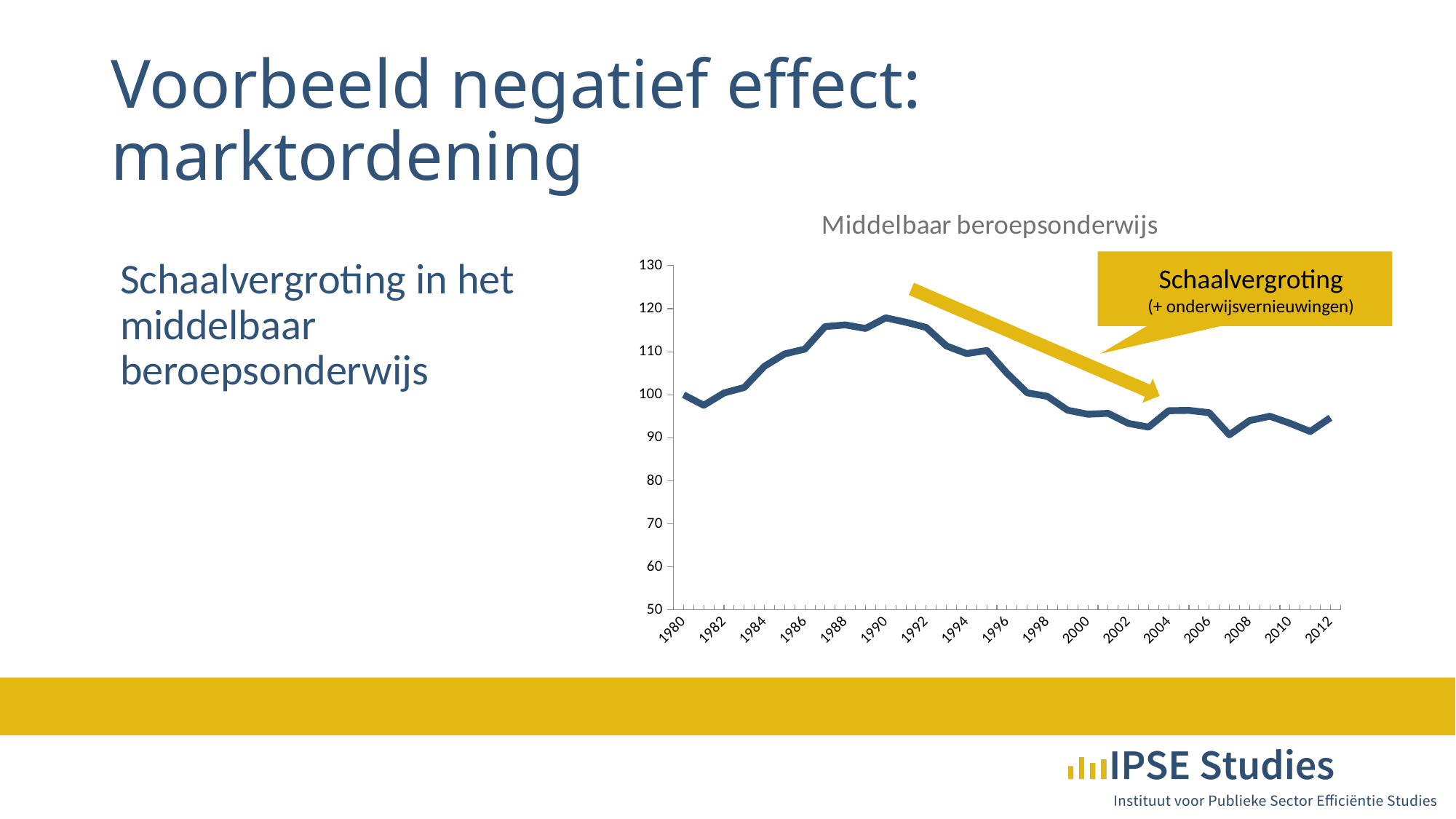
Is the value for 2012 greater or less than 100? less Is the value for 1988 greater or less than 110? greater Is the value for 1990 greater or less than 110? greater What kind of chart is shown on the slide? line chart Does the line rise or fall between 1990 and 2003? fall In which year does the line reach its highest value? 1990 What is the title of the chart? Middelbaar beroepsonderwijs Does the line rise or fall between 1980 and 1990? rise What text is in the yellow callout box on the chart? Schaalvergroting (+ onderwijsvernieuwingen)